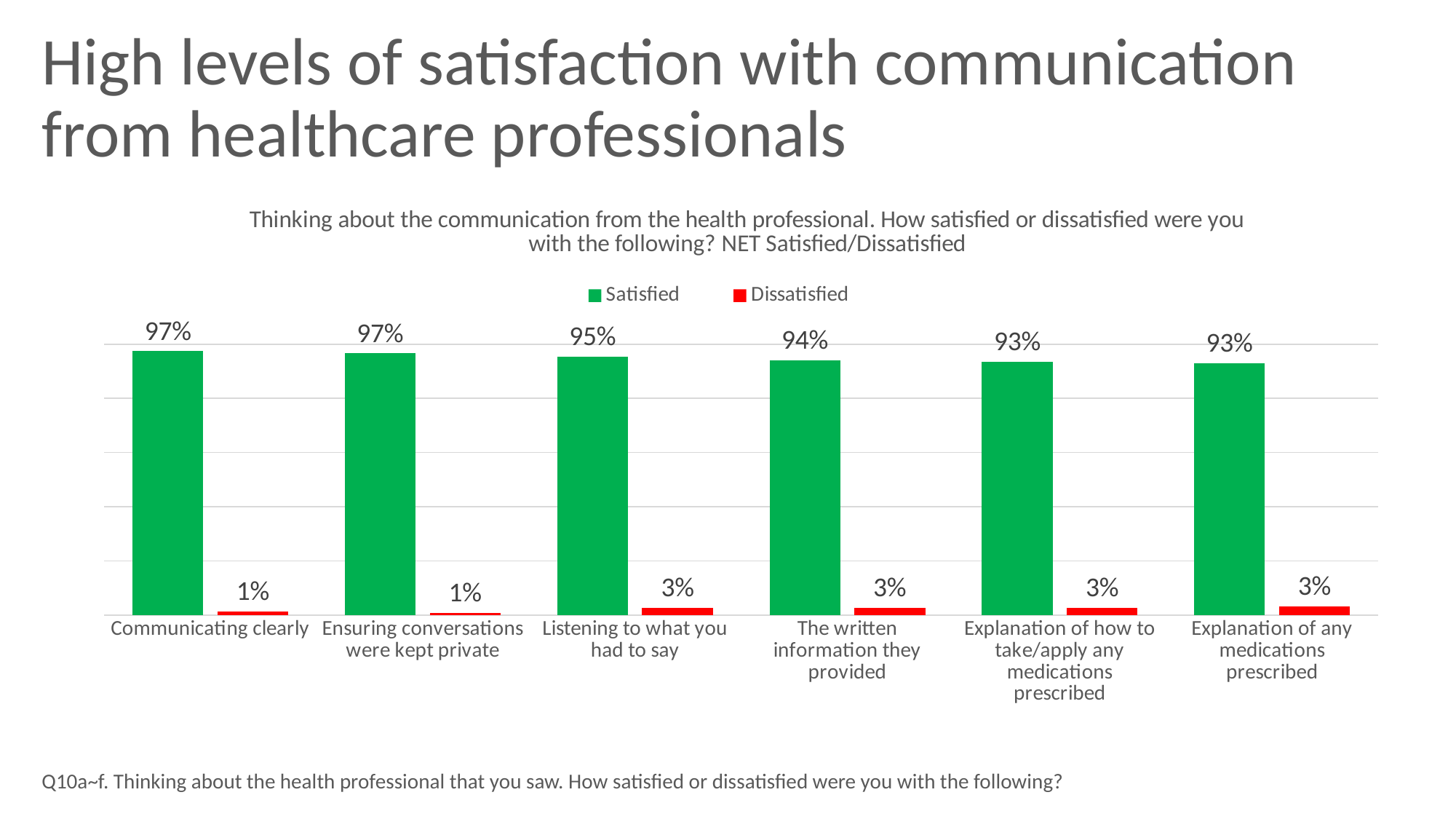
What is the Dissatisfied value for 'The written information they provided'? 3% What colour are the Dissatisfied bars? Red What is the Dissatisfied value for 'Communicating clearly'? 1% What is the Satisfied value for 'Explanation of any medications prescribed'? 93% Which category has the lowest Satisfied value among 'Listening to what you had to say', 'The written information they provided' and 'Communicating clearly'? The written information they provided What is the difference between the Satisfied values for 'Communicating clearly' and 'Explanation of how to take/apply any medications prescribed'? 4% Which is larger: the Satisfied value for 'Ensuring conversations were kept private' or for 'The written information they provided'? Ensuring conversations were kept private Do the Satisfied values rise or fall from left to right across the categories? Fall What is the Satisfied value for 'Listening to what you had to say'? 95% What kind of chart is shown on the slide? Bar chart How many series does the legend list? 2 How many categories are shown on the x axis? 6